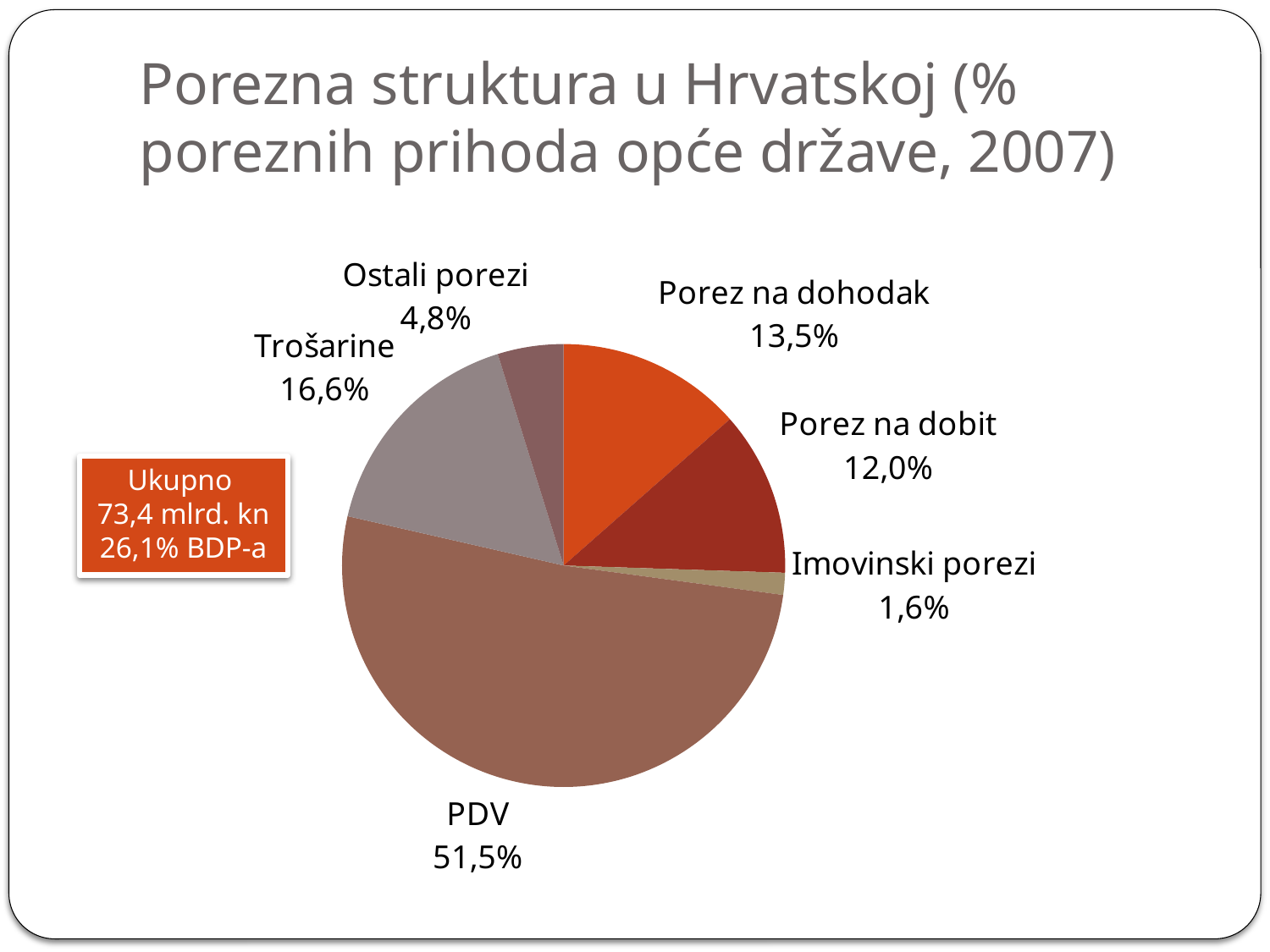
Which category has the largest slice of the pie? PDV What kind of chart is shown on the slide? Pie chart What share of tax revenue does PDV account for? 51,5% What is the difference between the shares of Porez na dohodak and Porez na dobit? 1,5% How many slices does the pie chart have? 6 Which is larger, the share for Trošarine or the share for Ostali porezi? Trošarine What is the combined share of Porez na dohodak and Porez na dobit? 25,5% What is the value shown for Porez na dohodak? 13,5% What total amount in mlrd. kn is shown in the box on the slide? 73,4 mlrd. kn Which category has the smallest slice of the pie? Imovinski porezi What is the value shown for Imovinski porezi? 1,6% What is the value shown for Trošarine? 16,6%